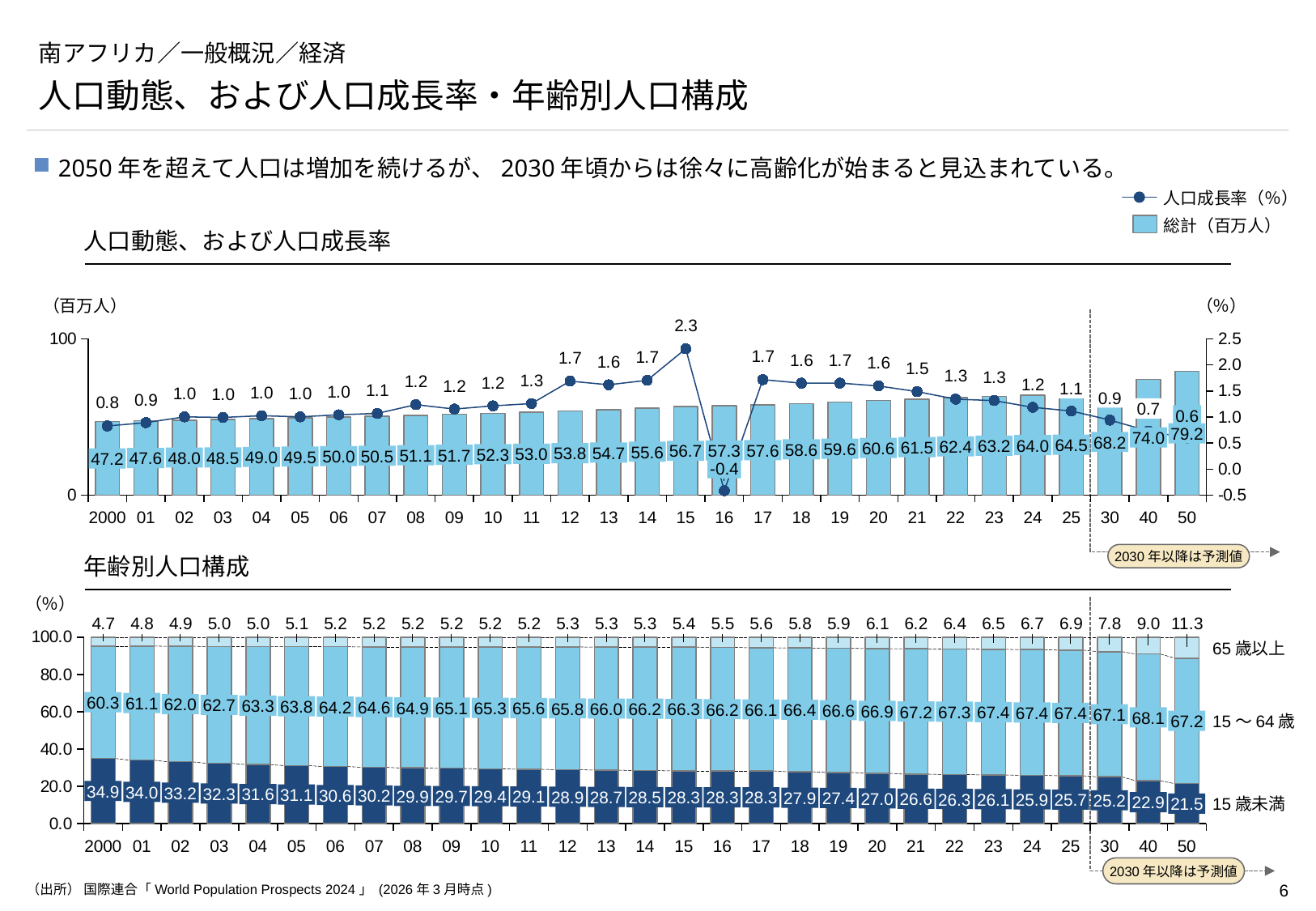
In the chart titled 人口動態、および人口成長率, what is the population growth rate (%) for 2015? 2.3 In the chart titled 年齢別人口構成, what is the value for 15歳未満 in 2000? 34.9 In the chart titled 人口動態、および人口成長率, how many series does the legend list? 2 In the chart titled 人口動態、および人口成長率, what is the difference between the total population in 2050 and in 2000? 32.0 In the chart titled 人口動態、および人口成長率, which year has the lowest population growth rate? 2016 In the chart titled 人口動態、および人口成長率, which year has the highest population growth rate? 2015 In the chart titled 年齢別人口構成, what is the value for 65歳以上 in 2050? 11.3 In the chart titled 年齢別人口構成, what is the difference between the 15歳未満 value in 2000 and in 2050? 13.4 In the chart titled 人口動態、および人口成長率, does the total population rise or fall from 2000 to 2050? rise In the chart titled 年齢別人口構成, which year has the highest value for 15～64歳? 2040 In the chart titled 年齢別人口構成, does the share of 15歳未満 rise or fall from 2000 to 2050? fall In the chart titled 人口動態、および人口成長率, what is the total population (百万人) for 2000? 47.2